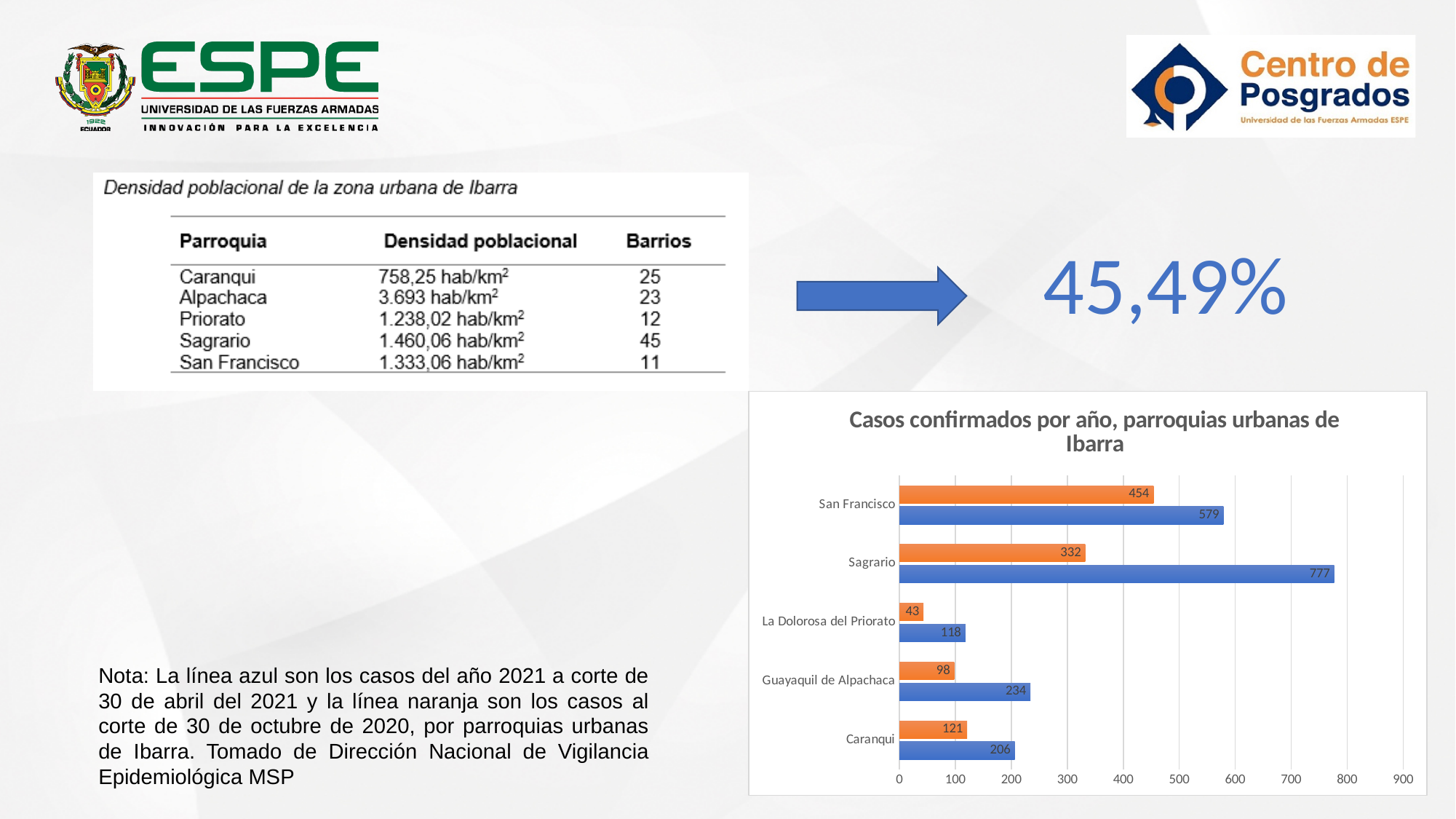
What is the value of the orange bar for San Francisco in the chart? 454 What is the difference between the blue bar values for San Francisco and Caranqui? 373 How many parroquias are shown on the chart's vertical axis? 5 What is the difference between the blue and orange bar values for Sagrario? 445 Which parroquia has the lowest orange bar value in the chart? La Dolorosa del Priorato Which parroquia has the highest blue bar value in the chart? Sagrario Which is larger: the orange bar for Caranqui or the orange bar for Guayaquil de Alpachaca? Caranqui What is the value of the blue bar for Sagrario in the chart 'Casos confirmados por año, parroquias urbanas de Ibarra'? 777 According to the note on the slide, which year do the blue bars in the chart represent? 2021 What is the value of the blue bar for Guayaquil de Alpachaca? 234 What is the value of the orange bar for La Dolorosa del Priorato? 43 What type of chart is 'Casos confirmados por año, parroquias urbanas de Ibarra'? Bar chart